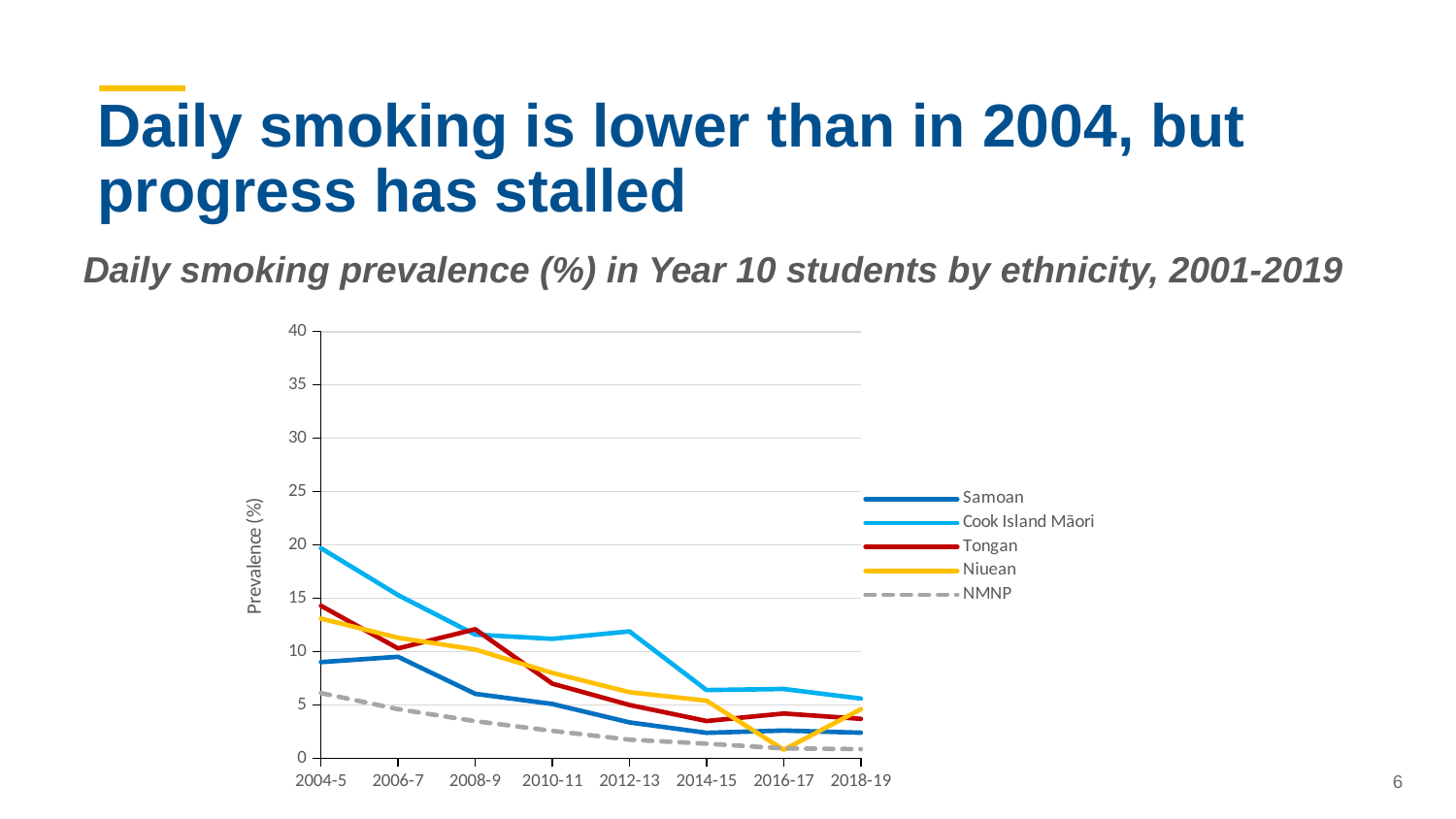
How many series does the legend list? 5 Is the value for Cook Island Māori in 2004-5 greater or less than 15? greater Is the value for Tongan in 2004-5 greater or less than 10? greater Is the value for Samoan in 2004-5 greater or less than 10? less In 2014-15, which is larger: the value for Cook Island Māori or the value for Samoan? Cook Island Māori Do the values for Samoan generally rise or fall from 2004-5 to 2018-19? Fall Which series is drawn with a dashed line? NMNP Which series has the lowest value in 2004-5? NMNP How many time periods are shown along the x axis? 8 What kind of chart is shown on the slide? Line chart Which ethnic group has the highest daily smoking prevalence in 2004-5? Cook Island Māori